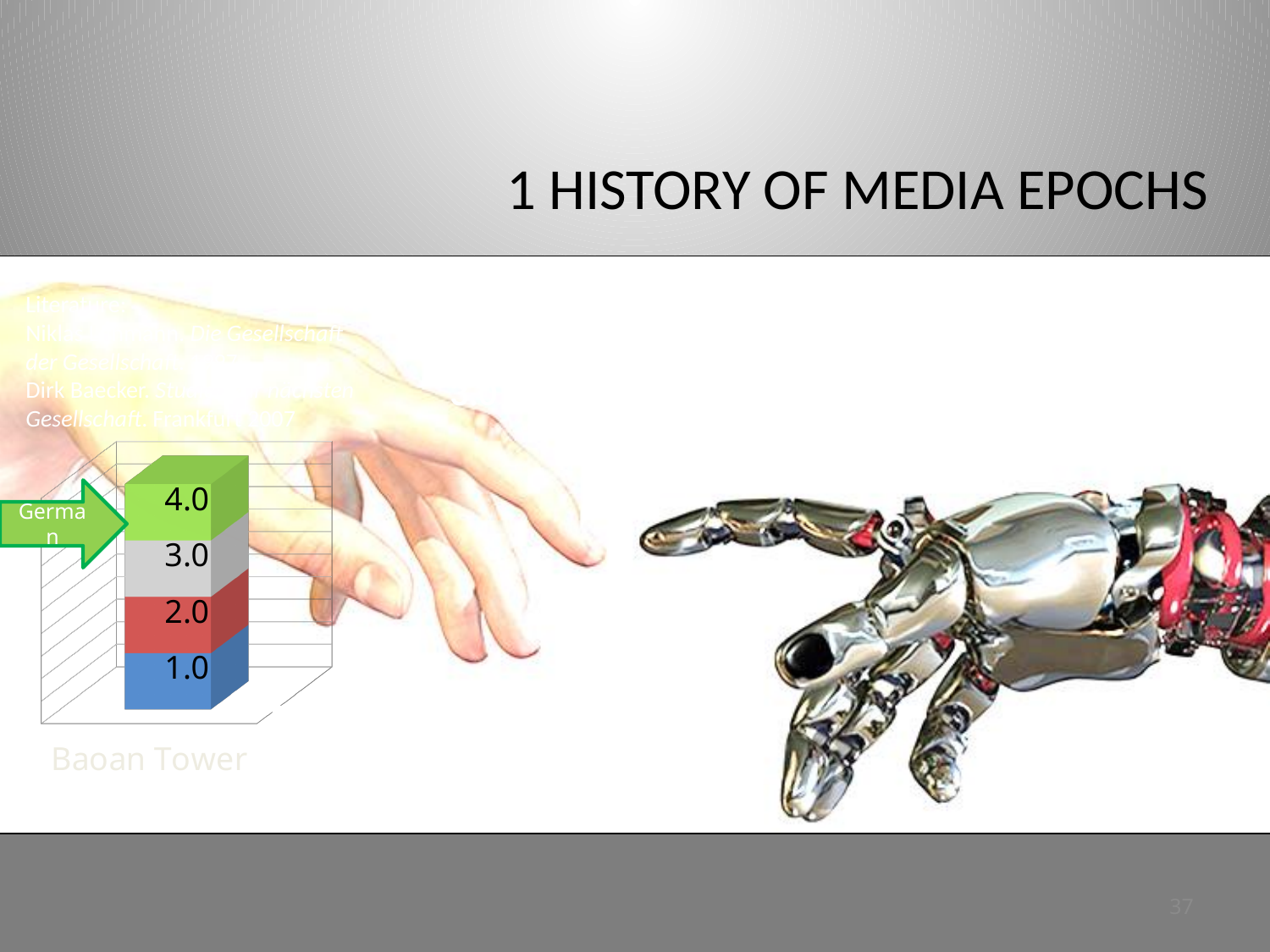
What value is printed on the grey segment of the stacked bar? 3.0 How many segments make up the stacked bar in the chart? 4 Is the value printed on the red segment larger or smaller than the value on the grey segment? smaller What text appears directly below the chart? Baoan Tower Which segment of the stacked bar has the smallest printed value? the bottom blue segment (1.0) What value is printed on the bottom (blue) segment of the stacked bar? 1.0 What is the difference between the values printed on the green and blue segments? 3.0 What value is printed on the top (green) segment of the stacked bar? 4.0 What kind of chart is shown on the slide? stacked bar chart Which segment of the stacked bar has the largest printed value? the top green segment (4.0) What value is printed on the red segment of the stacked bar? 2.0 What is the total of the four values printed on the stacked bar? 10.0